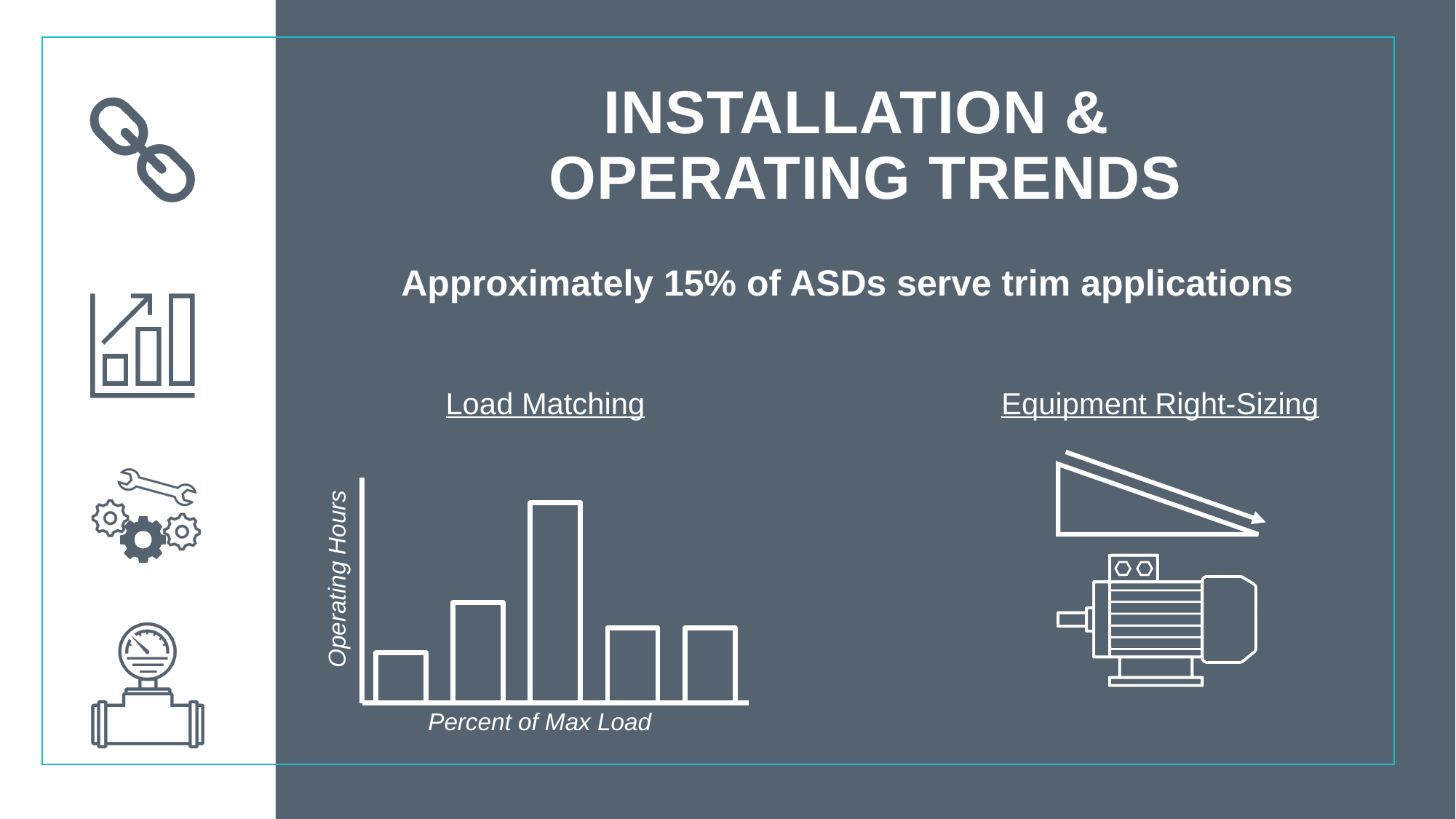
In the Load Matching chart, which is taller: the second bar or the fourth bar? the second bar In the Load Matching chart, which bar (by position from the left) is the shortest? the first bar How many bars does the Load Matching chart contain? 5 What kind of chart is shown under the heading "Load Matching"? bar chart In the Load Matching chart, which bar (by position from the left) is the tallest? the third bar In the Load Matching chart, do the bar heights rise or fall from the third bar to the fourth bar? fall In the Load Matching chart, do the bar heights rise or fall from the first bar to the third bar? rise What is the label on the horizontal axis of the Load Matching chart? Percent of Max Load In the Load Matching chart, which is taller: the first bar or the fifth bar? the fifth bar What is the label on the vertical axis of the Load Matching chart? Operating Hours